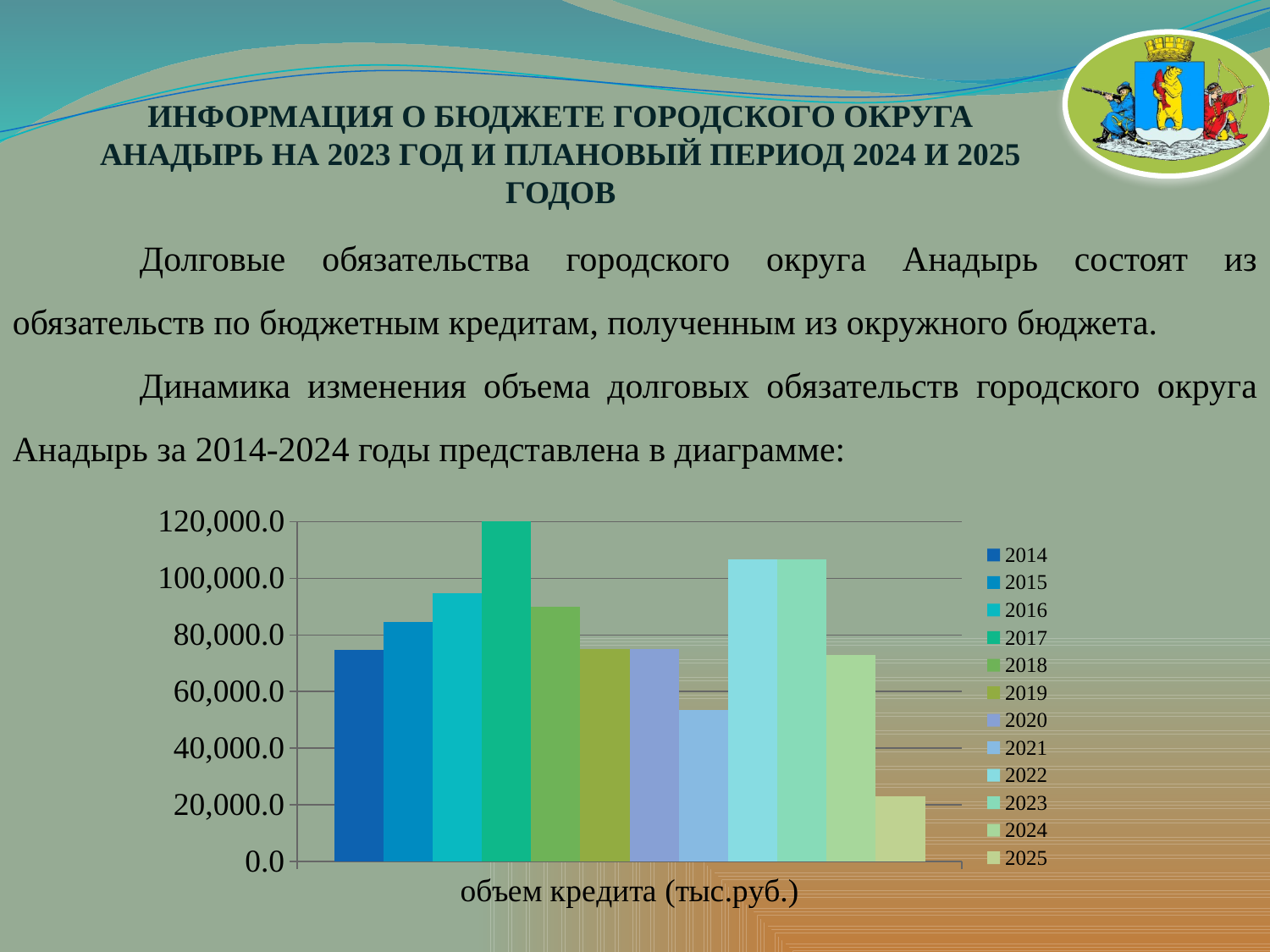
Which is larger, the value for 2022 or the value for 2024? 2022 Which year has the lowest bar in the chart? 2025 Is the value for 2016 greater or less than 100,000.0? less Which year has the highest bar in the chart? 2017 Is the value for 2025 greater or less than 40,000.0? less Is the value for 2021 greater or less than 60,000.0? less How many series does the legend list? 12 What is the label shown under the x axis of the chart? объем кредита (тыс.руб.) What kind of chart is shown on the slide? bar chart Which is larger, the value for 2017 or the value for 2021? 2017